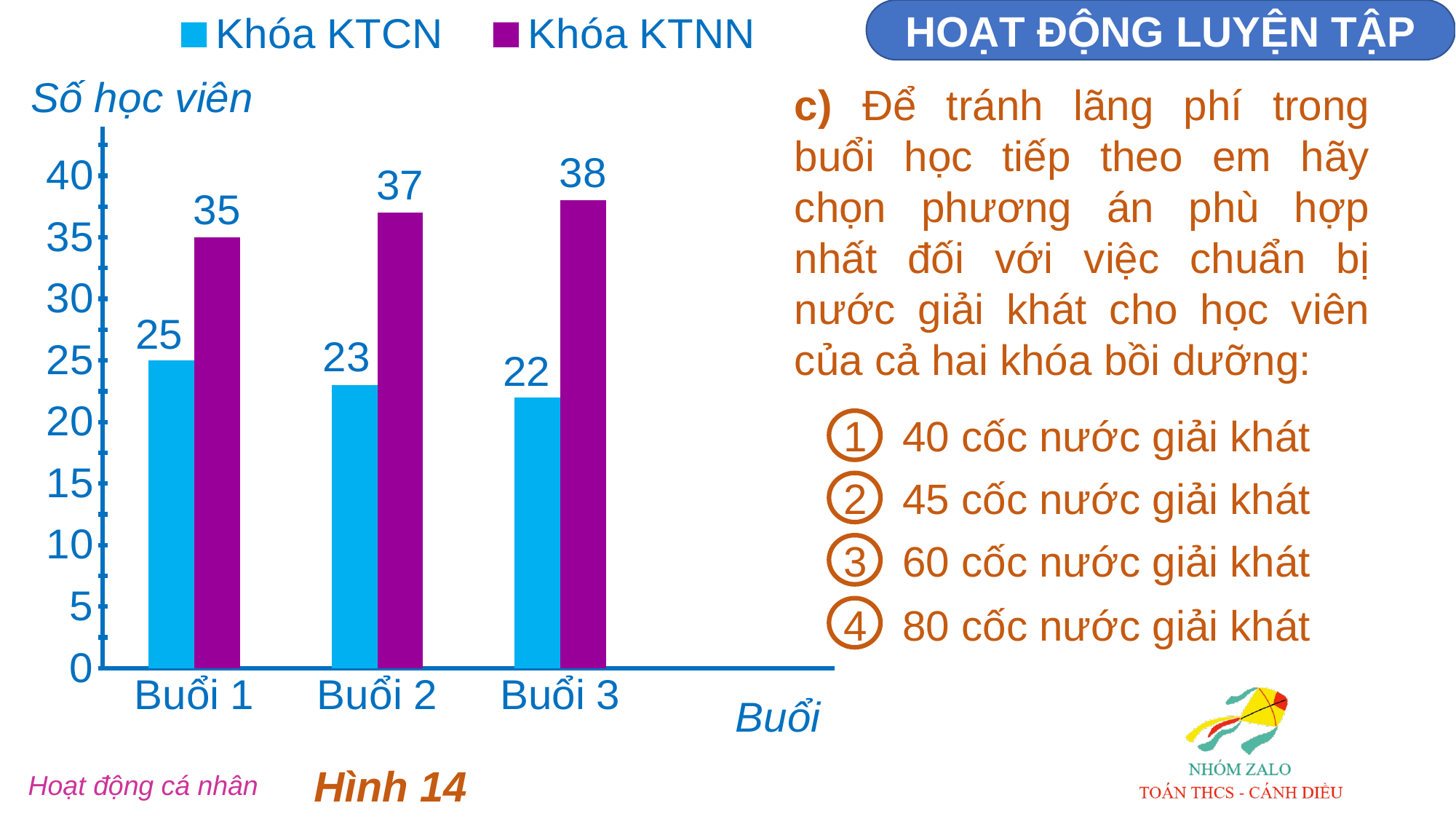
Which session (Buổi) has the highest value for Khóa KTNN? Buổi 3 Which session (Buổi) has the lowest value for Khóa KTCN? Buổi 3 Which is larger in Buổi 2: Khóa KTCN or Khóa KTNN? Khóa KTNN What is the value for Khóa KTNN in Buổi 3? 38 What kind of chart is shown? Bar chart Do the values for Khóa KTCN rise or fall from Buổi 1 to Buổi 3? Fall What is the difference between Khóa KTNN and Khóa KTCN in Buổi 1? 10 How many series does the legend list? 2 What is the value for Khóa KTCN in Buổi 1? 25 What is the value for Khóa KTNN in Buổi 2? 37 How many sessions (Buổi) are shown on the x axis? 3 What is the difference between Khóa KTNN and Khóa KTCN in Buổi 3? 16